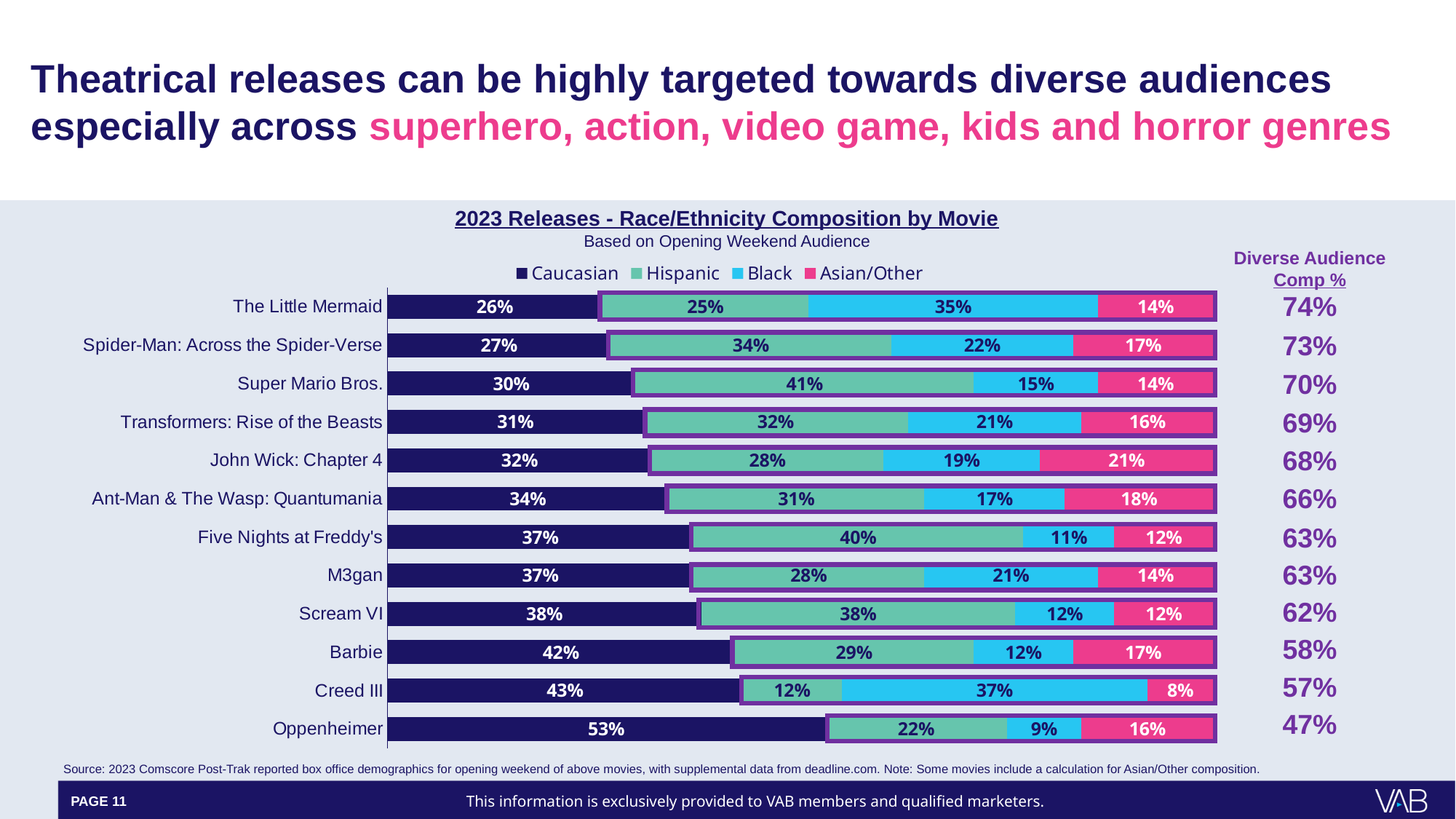
What is the combined Hispanic, Black and Asian/Other share for Scream VI? 62% What is the Caucasian share of the opening weekend audience for Oppenheimer? 53% What is the Hispanic share for Super Mario Bros.? 41% What is the Black share of the opening weekend audience for Creed III? 37% Which movie has the lowest Asian/Other share? Creed III How many percentage points higher is the Caucasian share for Oppenheimer than for The Little Mermaid? 27 percentage points How many movies are shown in the chart? 12 Which movie has the larger Black share, The Little Mermaid or Spider-Man: Across the Spider-Verse? The Little Mermaid Which movie has the highest Caucasian share? Oppenheimer What is the Asian/Other share for John Wick: Chapter 4? 21% What kind of chart is shown on the slide? Stacked bar chart How many series does the legend list? 4